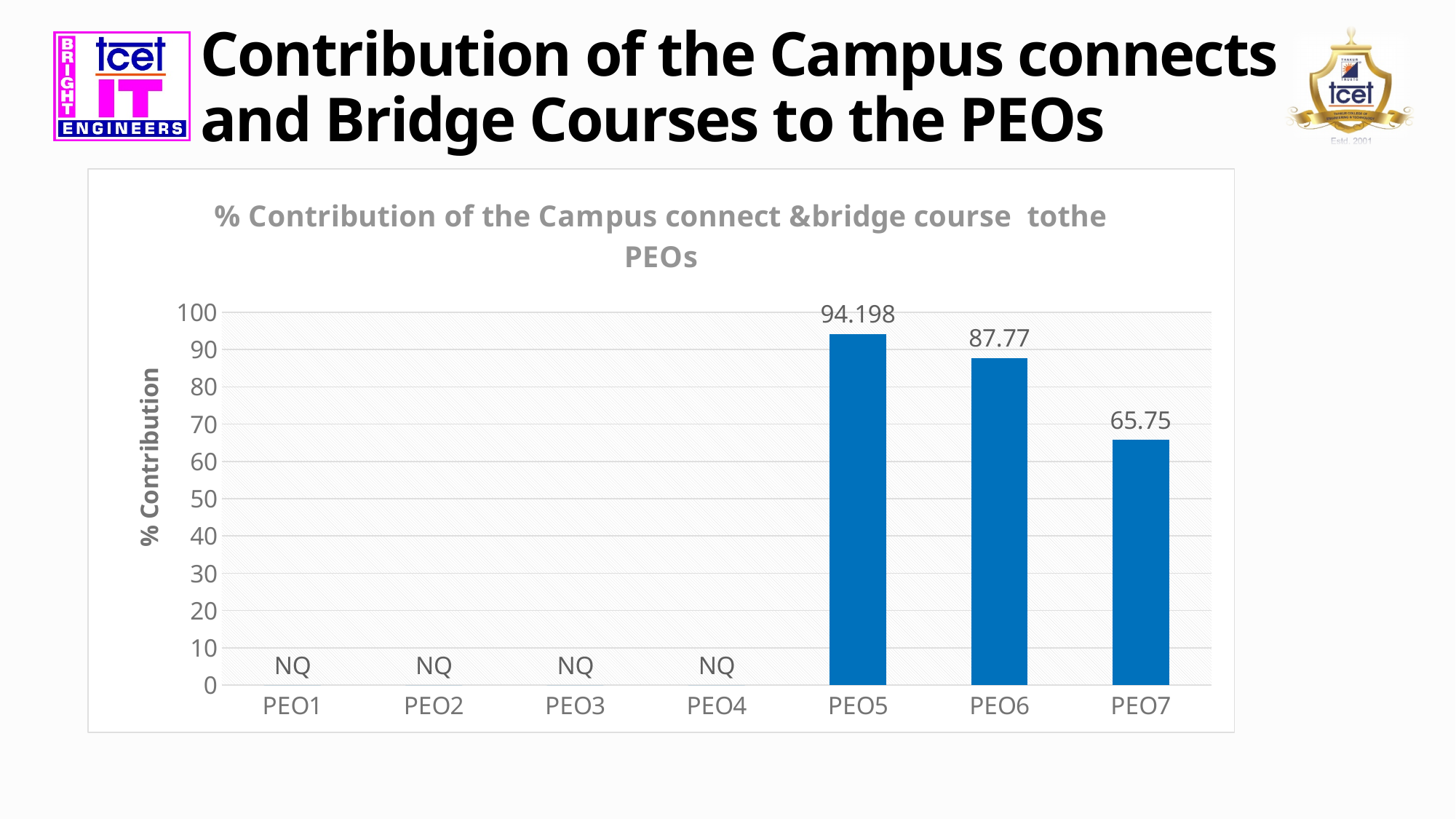
What is the value for PEO6? 87.77 What is the value for PEO7? 65.75 Which is larger, the value for PEO5 or PEO6? PEO5 What kind of chart is shown? bar chart What label is shown for PEO1 instead of a bar? NQ How many PEO categories are shown on the x axis? 7 Is the value for PEO7 greater or less than 70? less Which PEO has the highest % contribution? PEO5 What is the value for PEO5? 94.198 Among the PEOs with a plotted bar, which has the lowest % contribution? PEO7 What is the difference between the values for PEO6 and PEO7? 22.02 What is the label of the y axis? % Contribution